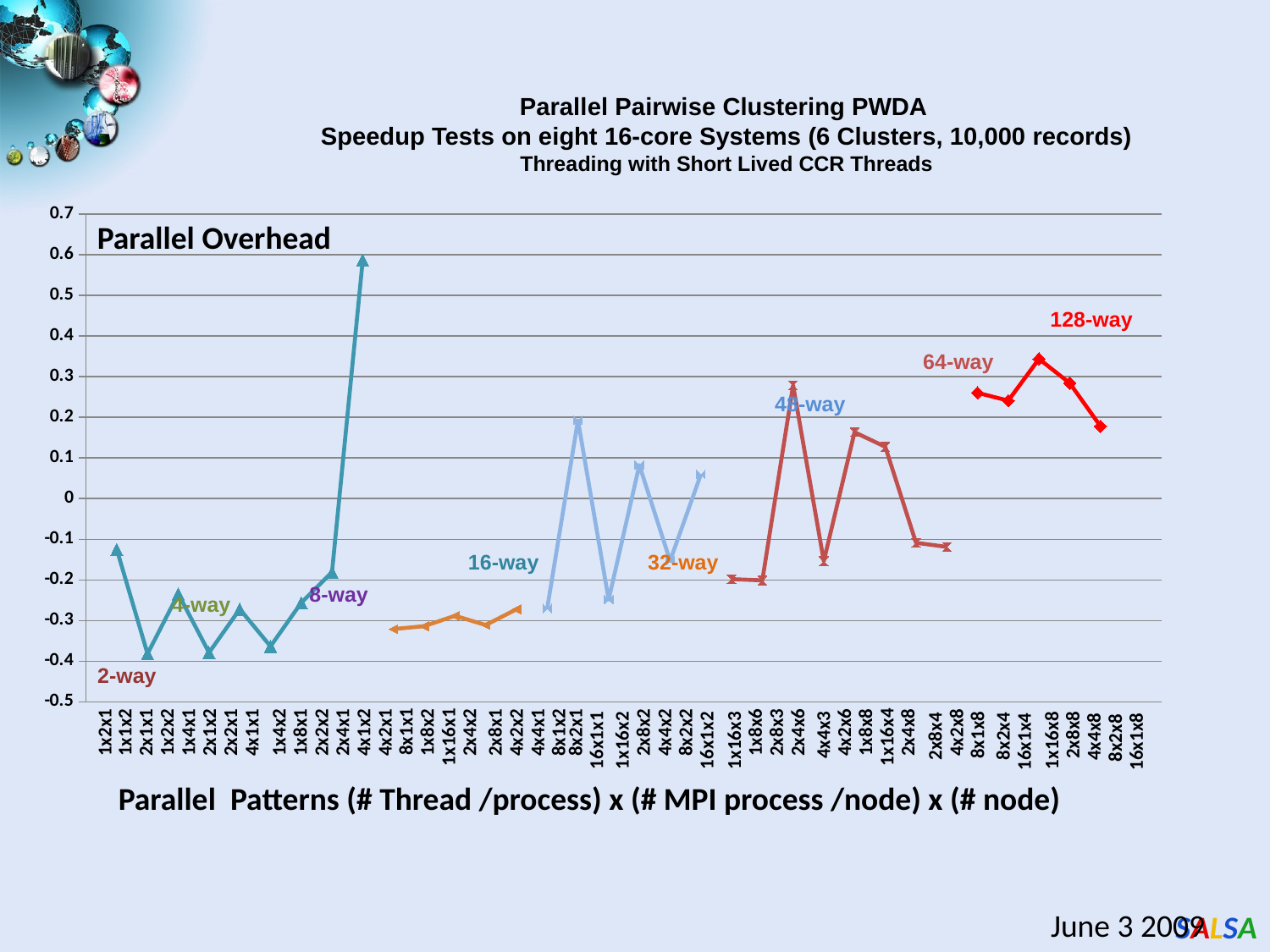
How many '-way' series labels are shown on the chart? 8 Which parallel pattern has the highest parallel overhead on the chart? 4x1x2 Is the value for 8x1x8 greater or less than 0.2? greater What is the x-axis label of the chart? Parallel Patterns (# Thread /process) x (# MPI process /node) x (# node) Does the 2-way series rise or fall from 1x2x1 to 2x1x1? fall What kind of chart is shown on the slide? line chart What is the title printed inside the chart area? Parallel Overhead Which has the larger parallel overhead, 2x4x6 or 1x8x8? 2x4x6 Is the value for 4x1x2 greater or less than 0.5? greater